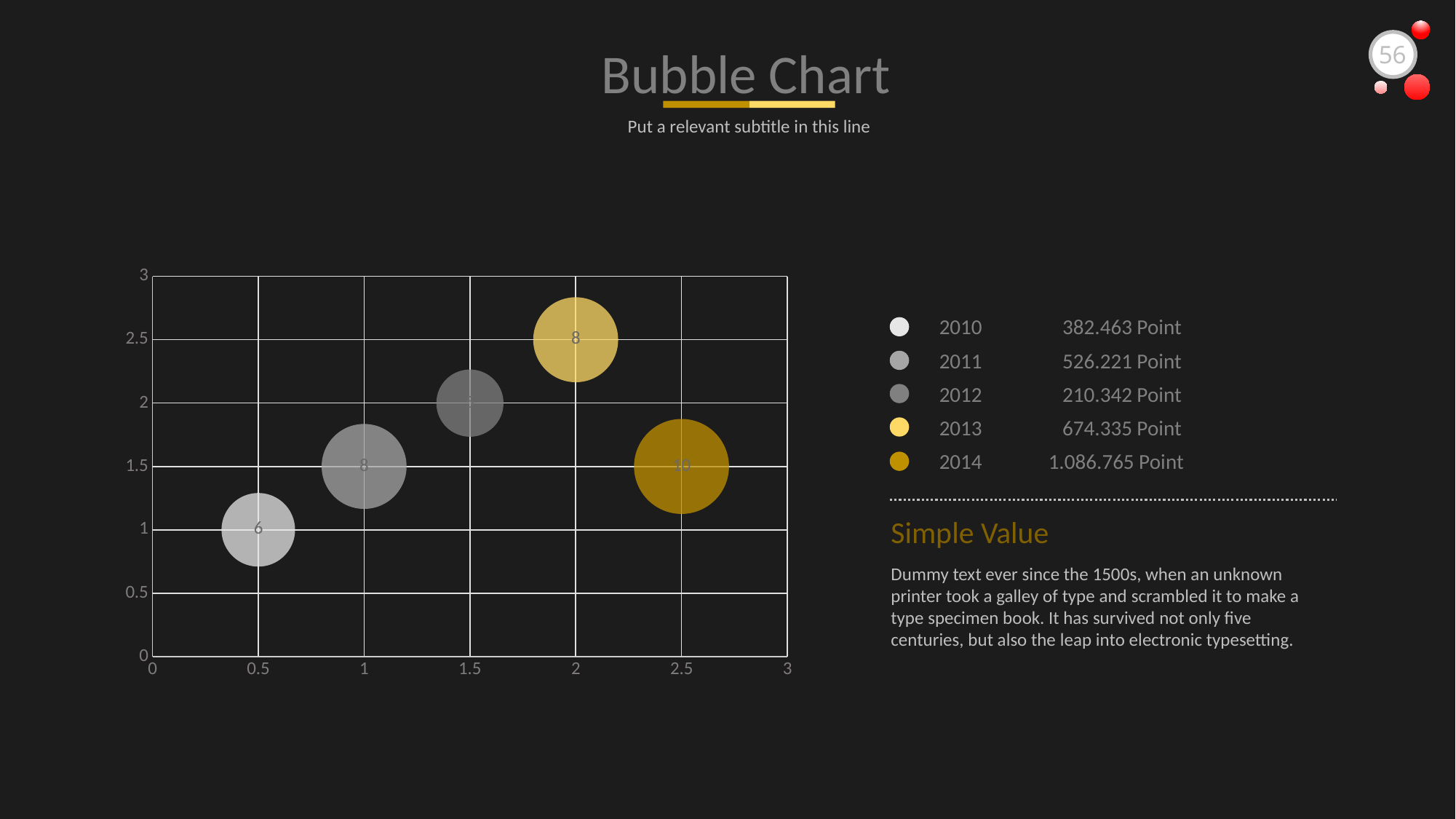
What value is printed on the bubble centred at x = 2.5? 10 Which bubble sits highest on the y axis? the bubble at x = 2 (y = 2.5) What value is printed on the bubble centred at x = 2? 8 Is the y value of the bubble at x = 2 greater or less than 2? greater What kind of chart is shown on the slide? bubble chart Is the y value of the bubble at x = 0.5 greater or less than 1.5? less At what y value is the bubble centred at x = 2.5 located? 1.5 How many bubbles are plotted on the chart? 5 Which has the larger printed value, the bubble at x = 2.5 or the bubble at x = 0.5? the bubble at x = 2.5 What is the difference between the printed values of the bubble at x = 2.5 and the bubble at x = 0.5? 4 Which bubble has the largest printed value? the bubble at x = 2.5 (value 10) What value is printed on the bubble centred at x = 0.5? 6